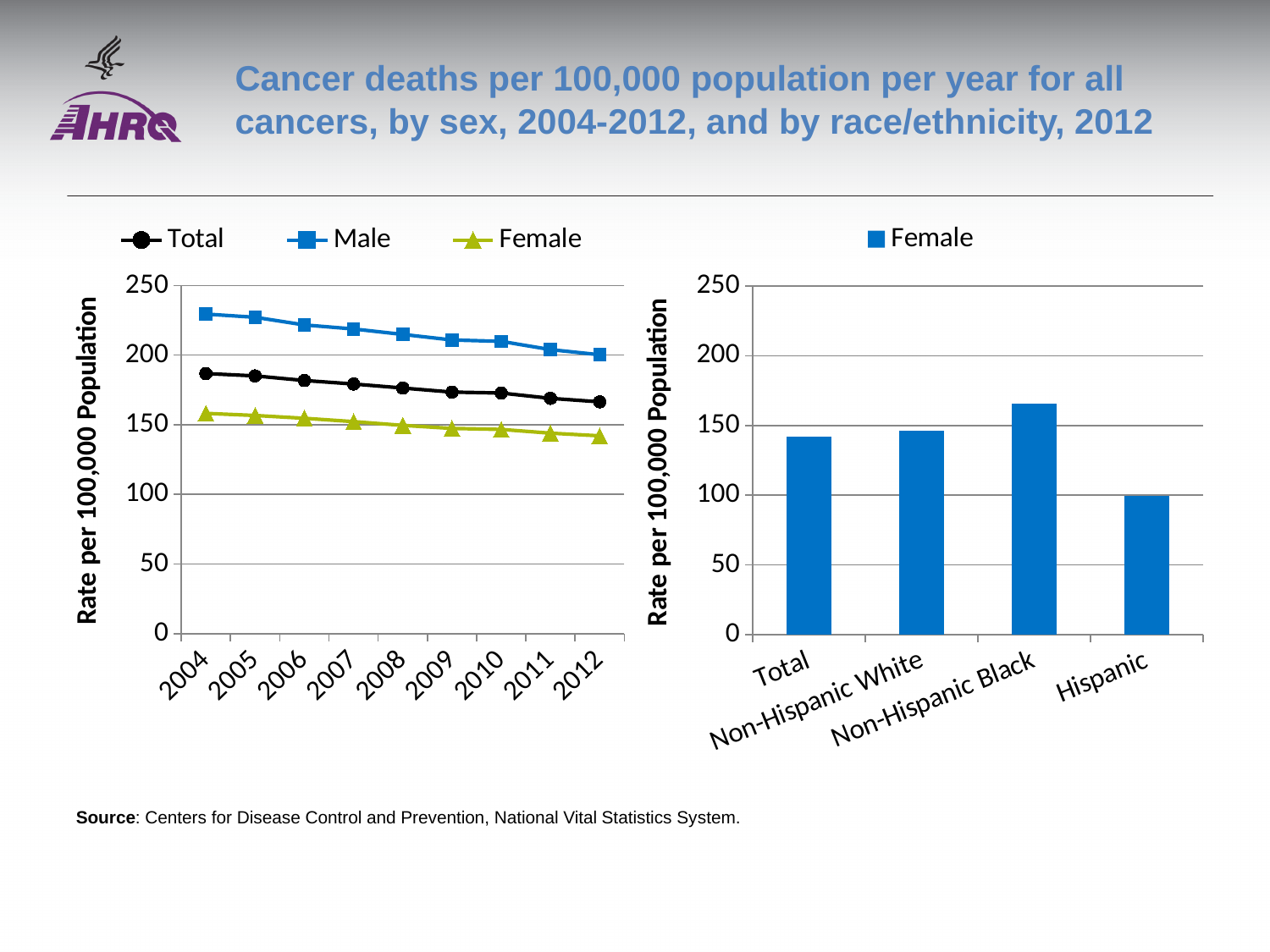
How many years are plotted on the x axis of the left chart? 9 In the left chart, is the Female value for 2012 greater or less than 150? less In the right chart, is the value for Non-Hispanic Black greater or less than 150? greater What type of chart is the left chart showing rates by sex from 2004 to 2012? line chart In the left chart, which series has the highest rate in every year? Male In the right chart, which race/ethnicity group has the highest female rate? Non-Hispanic Black How many series does the legend of the left chart list? 3 What type of chart is the right chart showing female rates by race/ethnicity? bar chart In the left chart, is the Male value for 2004 greater or less than 200? greater In the right chart, which race/ethnicity group has the lowest female rate? Hispanic In the left chart, does the Male rate rise or fall from 2004 to 2012? fall How many race/ethnicity categories are shown in the right chart? 4